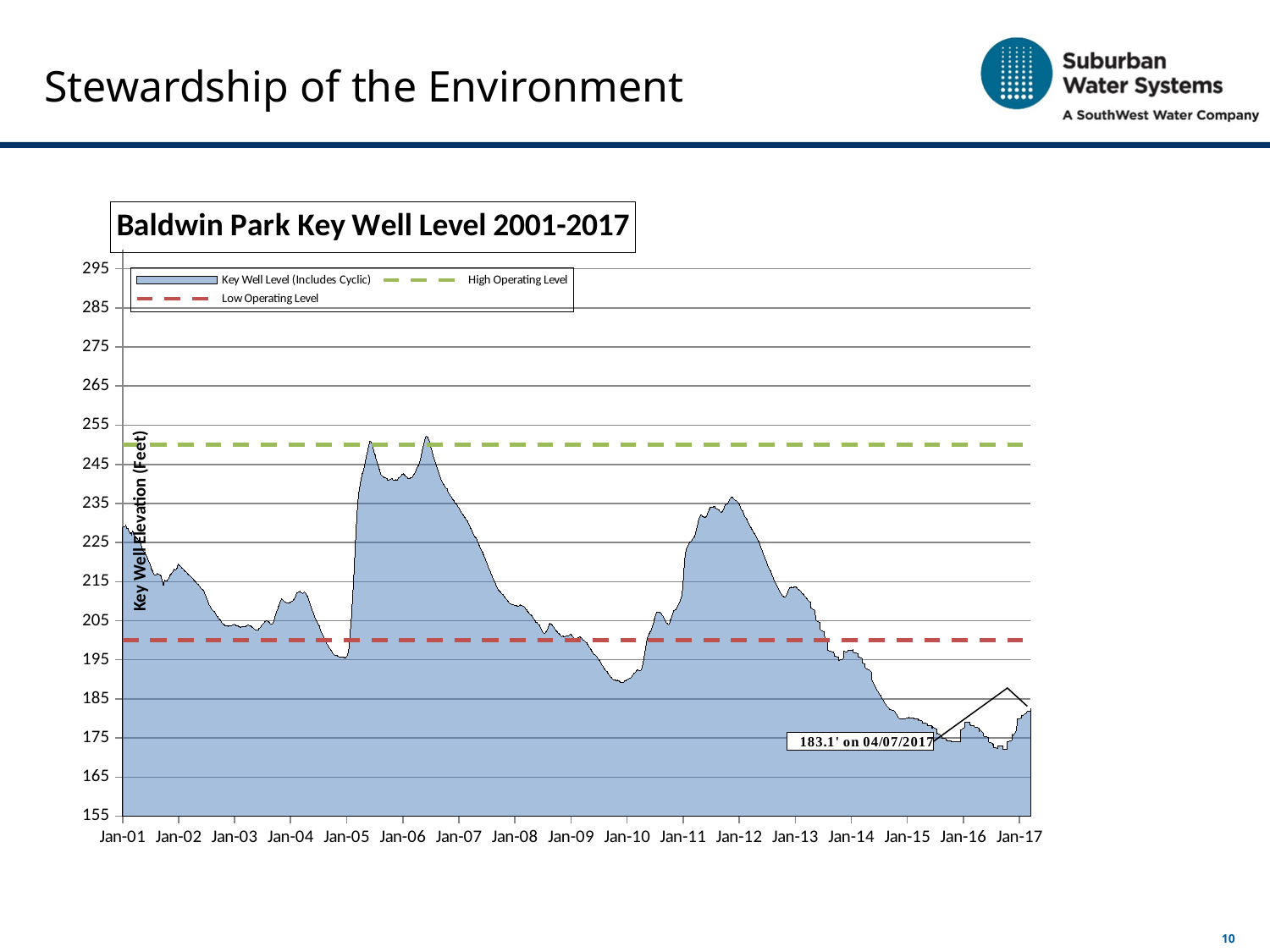
What key well level value is annotated on the chart for 04/07/2017? 183.1' Which is higher, the key well level at Jan-06 or at Jan-10? Jan-06 How many series does the chart legend list? 3 What is the label on the vertical axis of the chart? Key Well Elevation (Feet) Does the key well level rise or fall between Jan-12 and Jan-15? fall What is the title of the chart? Baldwin Park Key Well Level 2001-2017 Is the key well level at Jan-15 greater or less than 185? less Is the key well level at Jan-12 greater or less than 225? greater What kind of chart is shown on the slide? area chart Is the key well level at Jan-10 greater or less than 195? less